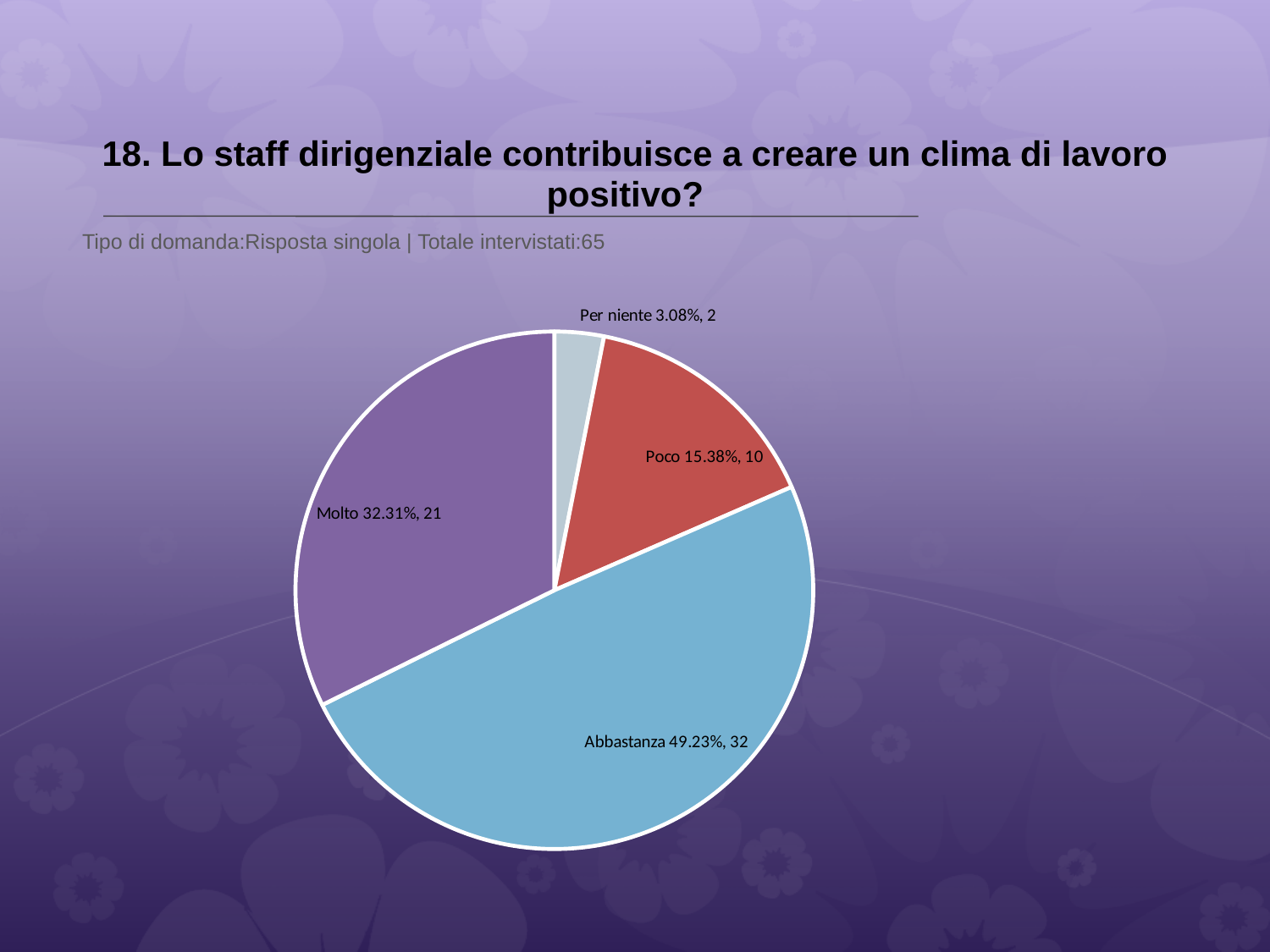
What is the difference in respondent count between 'Abbastanza' and 'Molto'? 11 What is the total number of respondents shown on the slide? 65 How many respondents answered 'Molto'? 21 Which has more respondents, 'Poco' or 'Molto'? Molto What kind of chart is shown on the slide? pie chart How many slices does the pie chart have? 4 Which category has the largest slice? Abbastanza What percentage share does the 'Poco' slice have? 15.38% Which category has the smallest slice? Per niente What colour is the 'Abbastanza' slice? blue How many respondents answered 'Per niente'? 2 What percentage share does the 'Abbastanza' slice have? 49.23%